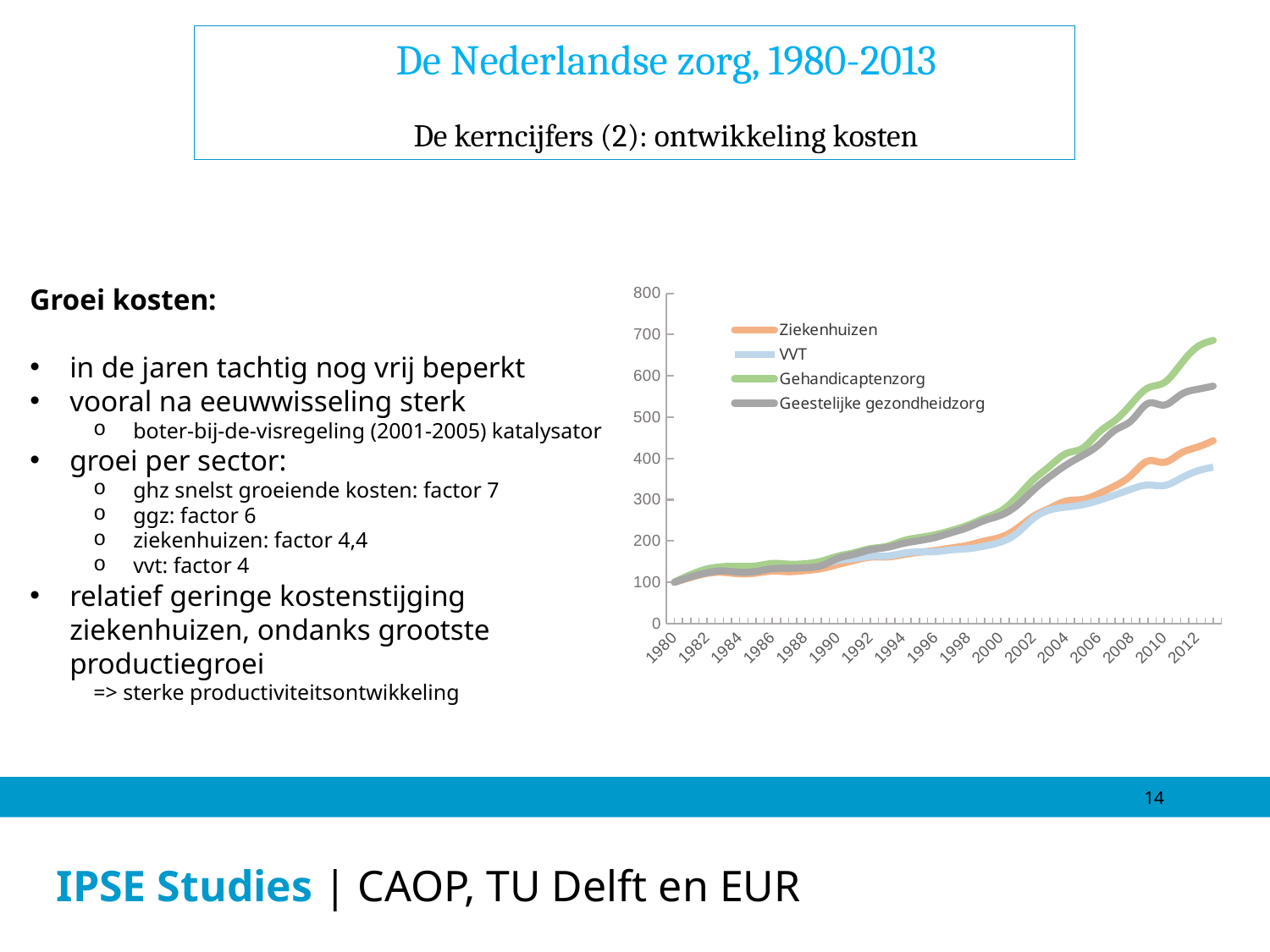
What colour is the Gehandicaptenzorg line in the chart? green Is the value for Ziekenhuizen in 2012 greater or less than 500? less Is the value for Geestelijke gezondheidzorg in 2012 greater or less than 500? greater How many series does the chart's legend list? 4 Which series has the lowest value at the right end of the chart (2013)? VVT What kind of chart is shown on the slide? line chart Which series has the highest value at the right end of the chart (2013)? Gehandicaptenzorg Is the value for Gehandicaptenzorg in 2012 greater or less than 600? greater What value do all four series start at in 1980? 100 Do the values of the series generally rise or fall from 1980 to 2013? rise In 2012, which is larger: the value for Ziekenhuizen or the value for VVT? Ziekenhuizen